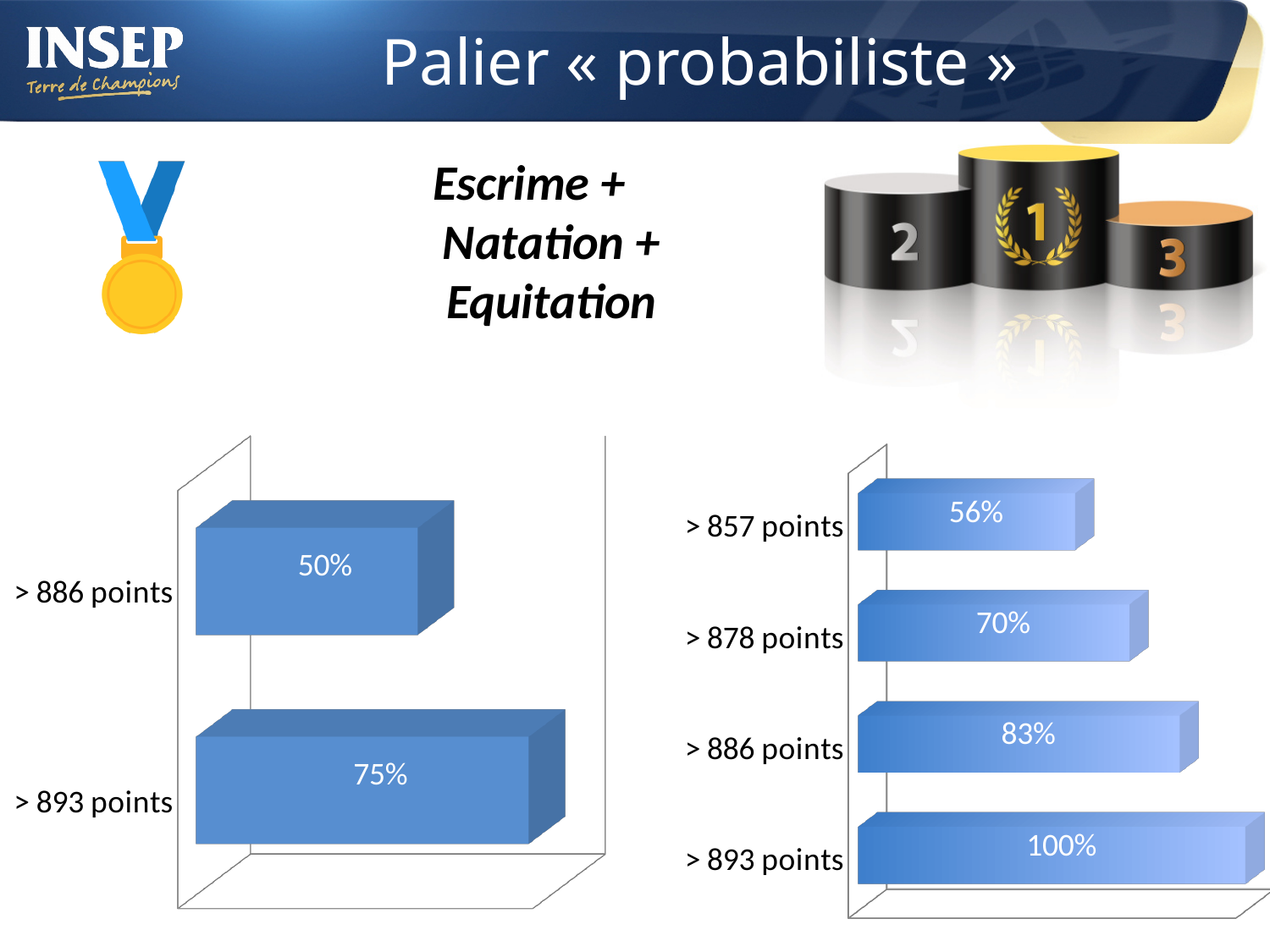
How many categories does the right chart show? 4 In the left chart, what is the difference between the values for > 893 points and > 886 points? 25% In the right chart, which is larger, the value for > 878 points or the value for > 886 points? > 886 points In the right chart, which category has the lowest value? > 857 points In the right chart, what is the value for > 886 points? 83% In the right chart, what is the value for > 878 points? 70% In the right chart, what is the value for > 857 points? 56% In the left chart, what is the value for > 893 points? 75% What kind of chart is the left chart? bar chart In the right chart, what is the difference between the values for > 893 points and > 857 points? 44% In the right chart, which category has the highest value? > 893 points In the left chart, what is the value for > 886 points? 50%